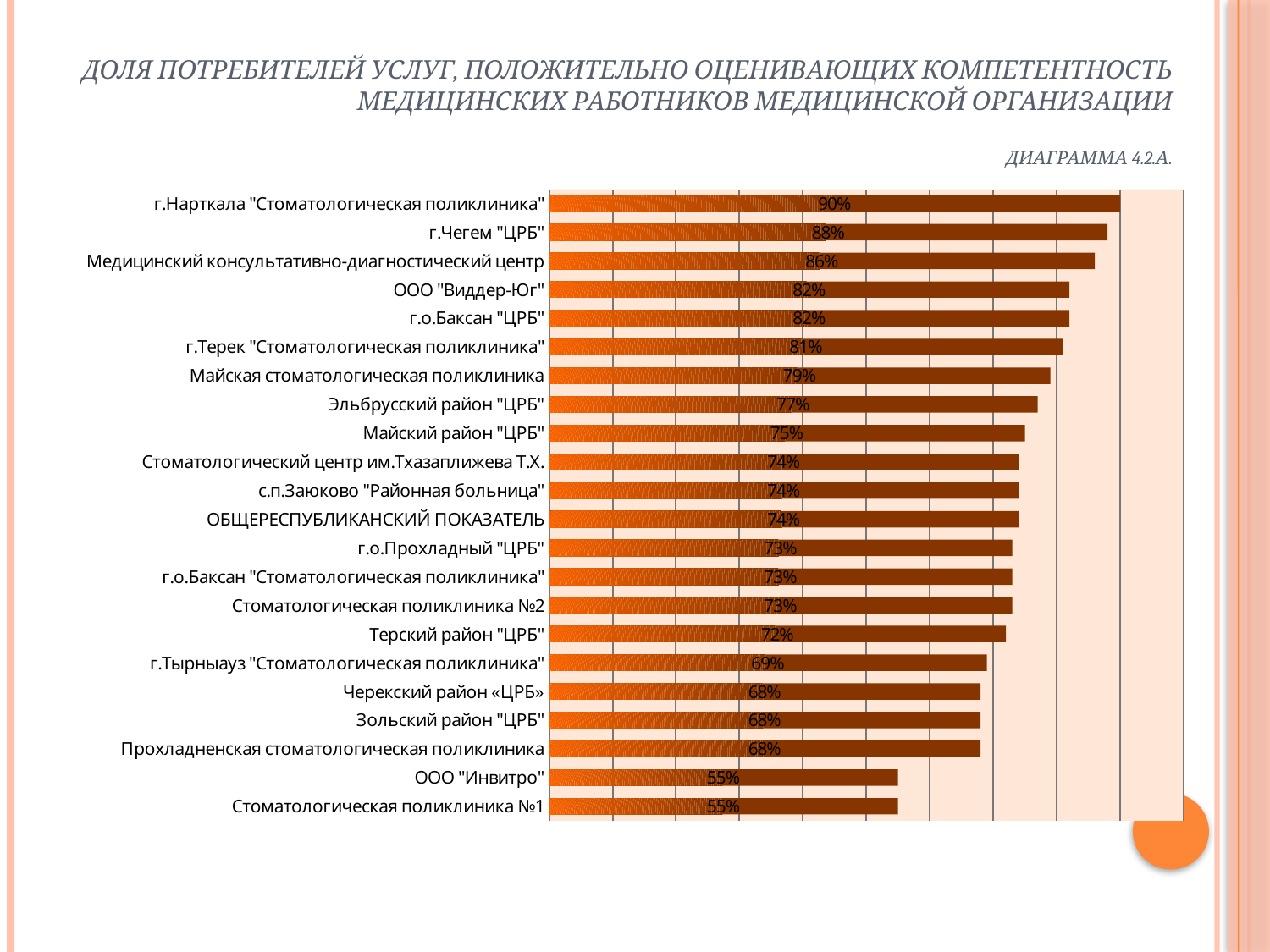
What is the value for Эльбрусский район "ЦРБ"? 77% Which organisation has the highest value on the chart? г.Нарткала "Стоматологическая поликлиника" What is the value for ОБЩЕРЕСПУБЛИКАНСКИЙ ПОКАЗАТЕЛЬ? 74% What is the difference between the values for г.Чегем "ЦРБ" and Терский район "ЦРБ"? 16% Which is larger: the value for Майская стоматологическая поликлиника or the value for г.Тырныауз "Стоматологическая поликлиника"? Майская стоматологическая поликлиника How many organisations (bars) are shown on the chart? 22 What is the difference between the value for Медицинский консультативно-диагностический центр and the ОБЩЕРЕСПУБЛИКАНСКИЙ ПОКАЗАТЕЛЬ? 12% What is the value for г.Нарткала "Стоматологическая поликлиника"? 90% What is the value for ООО "Инвитро"? 55% What type of chart is shown on the slide? bar chart What is the lowest value shown on the chart? 55% What is the diagram number given on the slide? ДИАГРАММА 4.2.А.